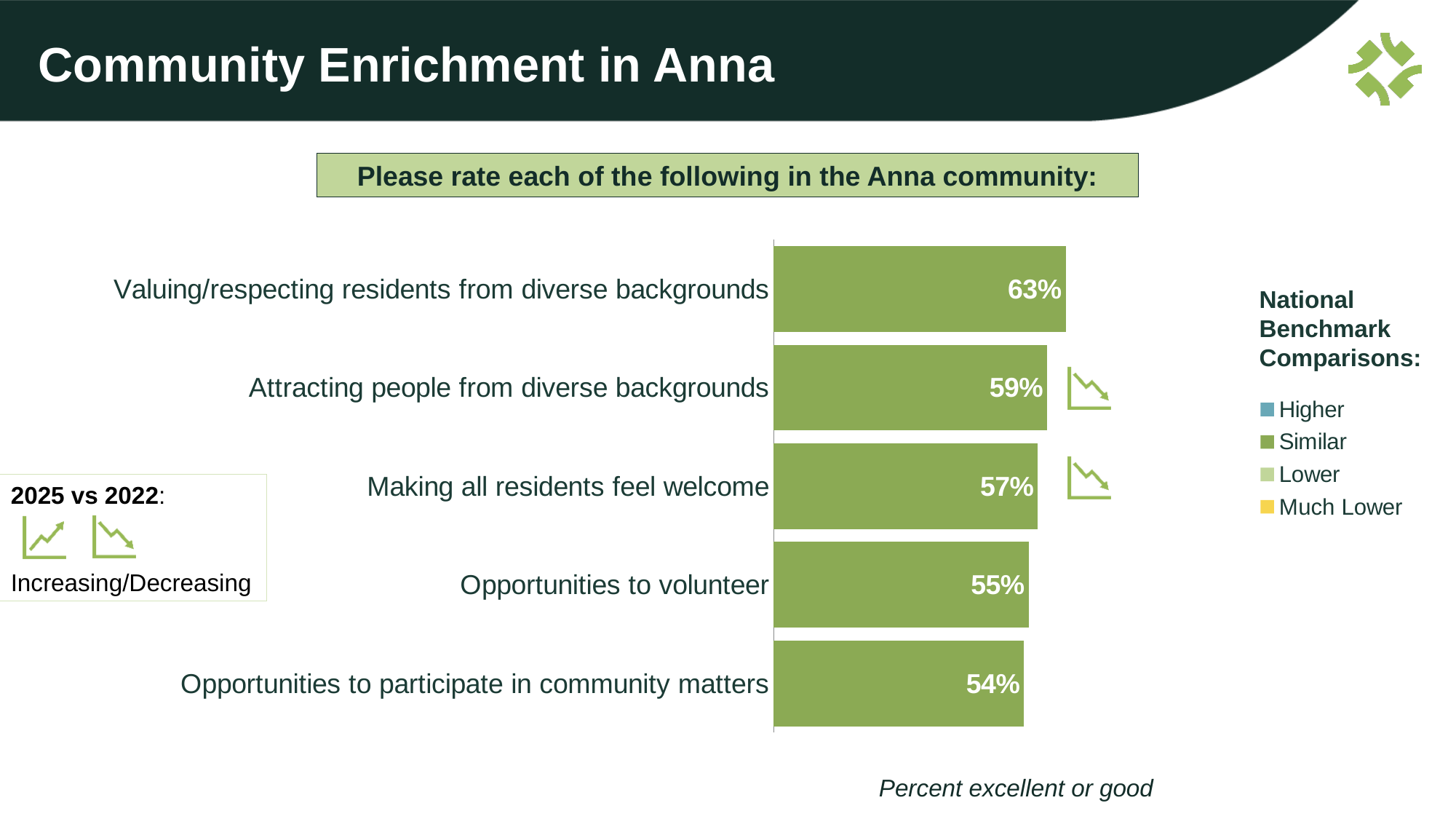
What is the value for 'Making all residents feel welcome'? 57% What is the value for 'Opportunities to volunteer'? 55% How many categories are shown in the chart? 5 What is the difference between 'Valuing/respecting residents from diverse backgrounds' and 'Opportunities to participate in community matters'? 9 percentage points What is the difference between 'Attracting people from diverse backgrounds' and 'Making all residents feel welcome'? 2 percentage points What percentage rated 'Valuing/respecting residents from diverse backgrounds' as excellent or good? 63% What kind of chart is shown on the slide? Bar chart Which category has the lowest value? Opportunities to participate in community matters Which is larger: 'Attracting people from diverse backgrounds' or 'Opportunities to volunteer'? Attracting people from diverse backgrounds How many categories are marked with a decreasing trend icon for 2025 vs 2022? 2 Which category has the highest value? Valuing/respecting residents from diverse backgrounds According to the National Benchmark Comparisons legend, what does the bar colour used in the chart indicate? Similar